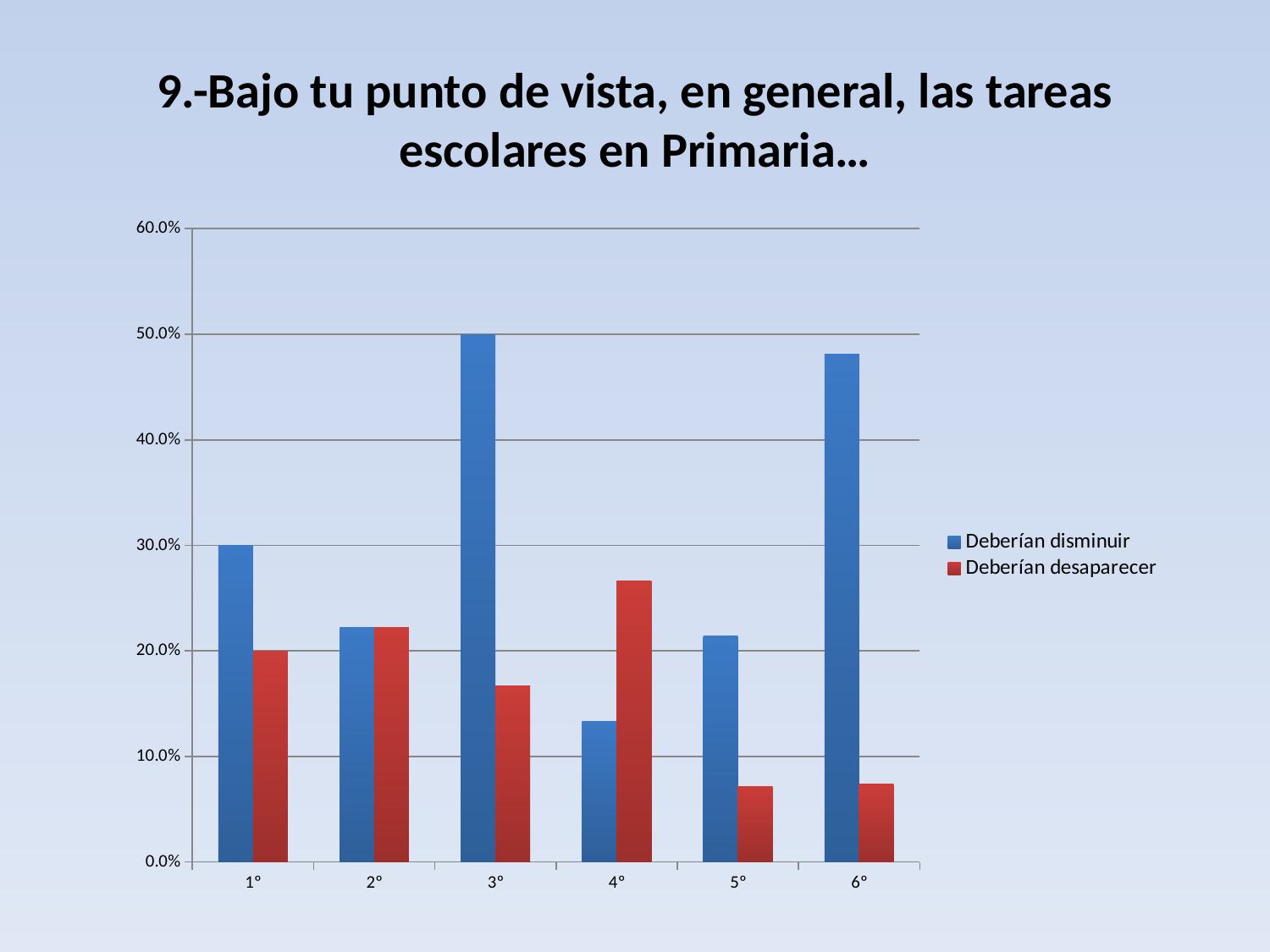
What is the difference between "Deberían disminuir" and "Deberían desaparecer" for 1°? 10.0% What is the value of "Deberían disminuir" for 1°? 30.0% How many series does the legend list? 2 How many grade categories are shown on the x axis? 6 What is the value of "Deberían disminuir" for 3°? 50.0% Is the value of "Deberían desaparecer" for 5° greater or less than 10.0%? less What kind of chart is shown on the slide? Bar chart For 4°, which is larger: "Deberían disminuir" or "Deberían desaparecer"? Deberían desaparecer For which grade is "Deberían desaparecer" highest? 4° What is the value of "Deberían desaparecer" for 1°? 20.0% For which grade is "Deberían disminuir" lowest? 4° Is the value of "Deberían disminuir" for 6° greater or less than 40.0%? greater